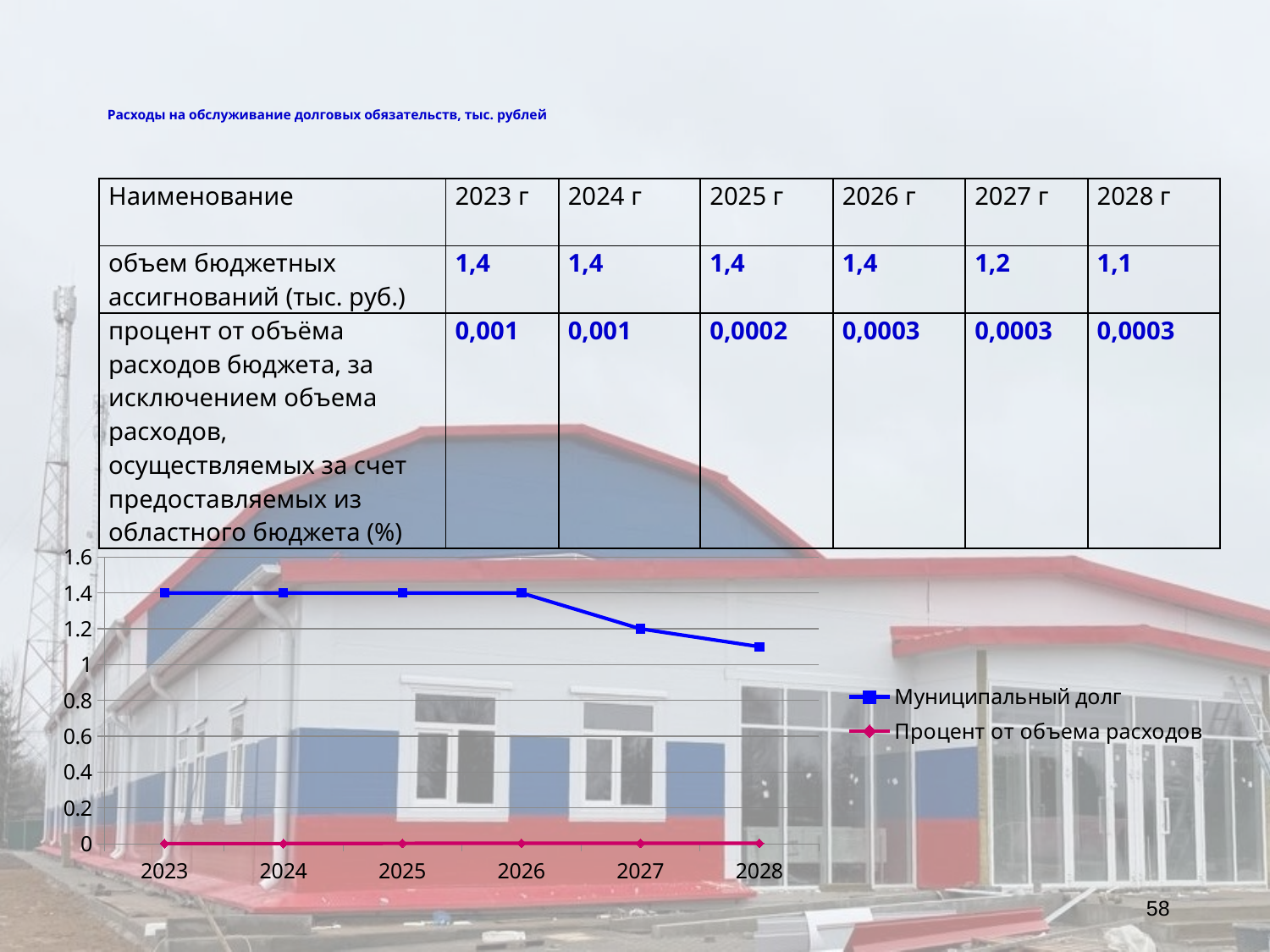
Does the Муниципальный долг line rise or fall from 2026 to 2028? fall How many years are plotted along the x axis of the chart? 6 Is the value of Муниципальный долг for 2026 greater or less than 1? greater Which year has the lowest value of Муниципальный долг on the chart? 2028 What is the value of Муниципальный долг for 2023 on the chart? 1.4 What is the value of Муниципальный долг for 2027 on the chart? 1.2 Which series is drawn in blue on the chart? Муниципальный долг Which is larger on the chart: Муниципальный долг in 2026 or in 2027? 2026 How many series does the chart legend list? 2 What kind of chart is shown on the slide? line chart What is the difference between Муниципальный долг in 2023 and in 2027 on the chart? 0.2 Is the value of Муниципальный долг for 2028 greater or less than 1.2? less